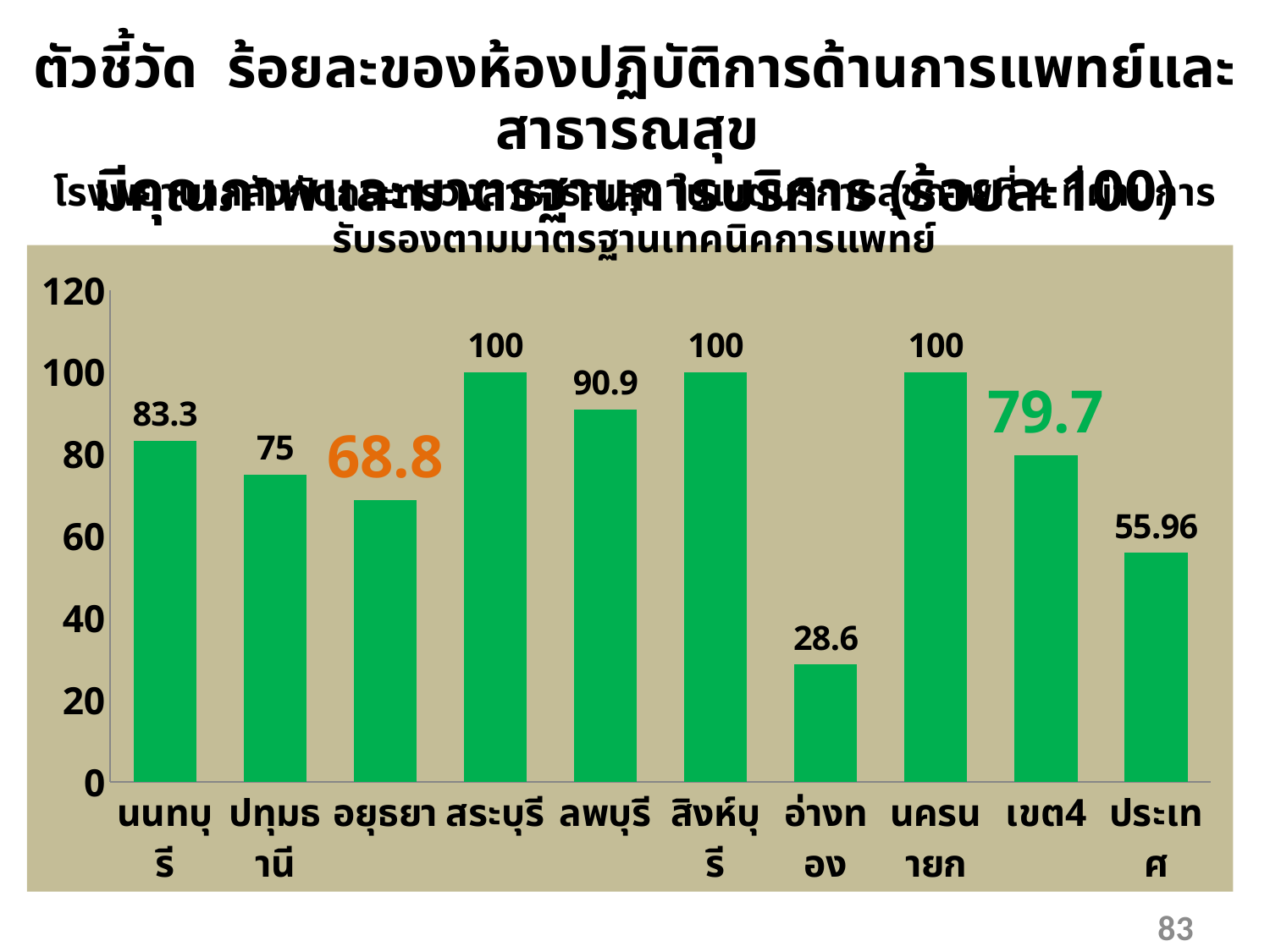
Which is larger, the value for นนทบุรี or the value for เขต4? นนทบุรี What is the difference between the values for ลพบุรี and ปทุมธานี? 15.9 How many categories have a value of 100? 3 What is the value for อยุธยา? 68.8 What is the value for เขต4? 79.7 What is the value for อ่างทอง? 28.6 Which category has the lowest value? อ่างทอง What is the value for ประเทศ? 55.96 Is the value for ประเทศ greater or less than 60? less What kind of chart is shown on the slide? bar chart What is the value for นนทบุรี? 83.3 How many categories are shown on the x axis? 10